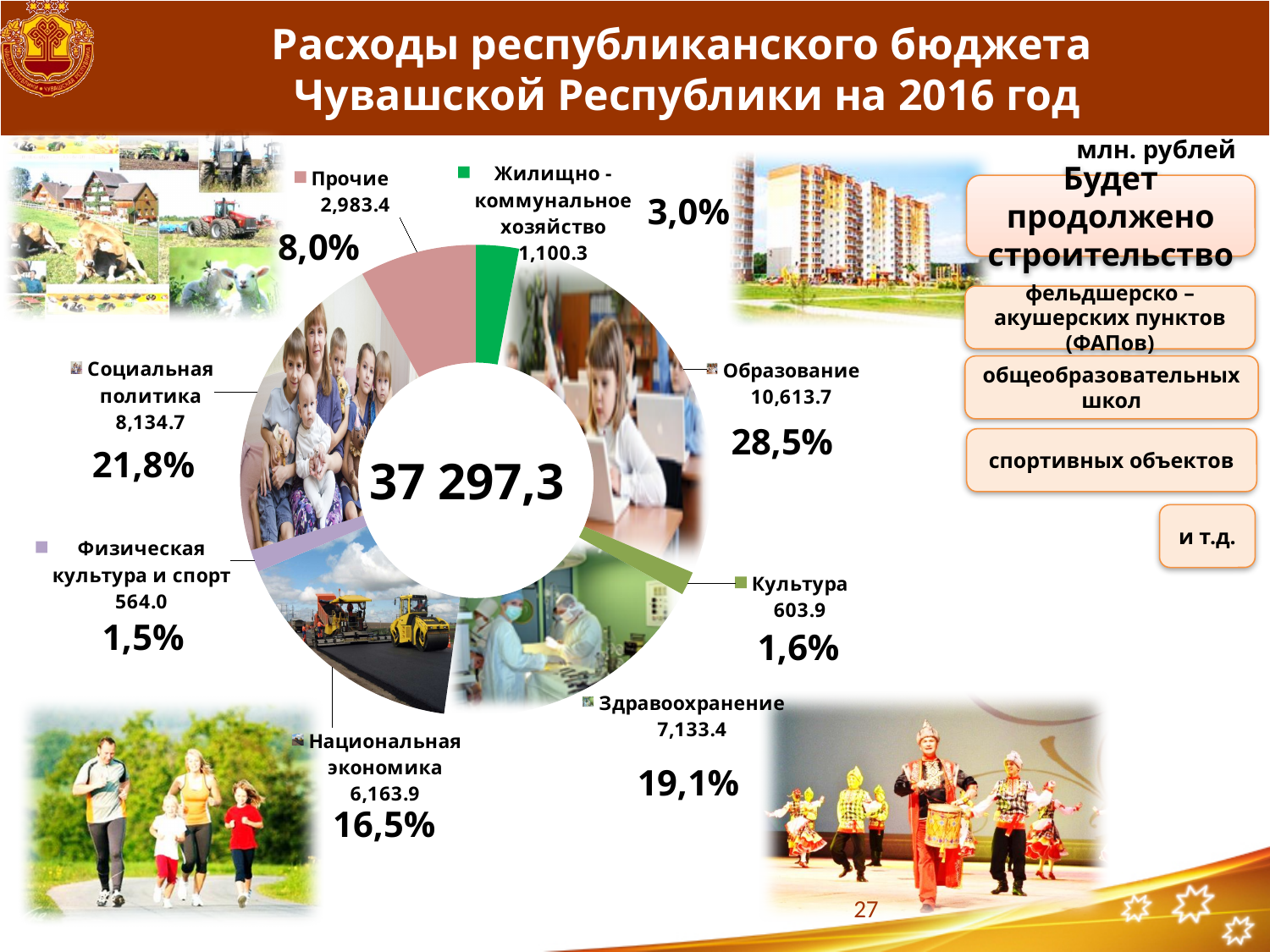
What share of the pie does Социальная политика take? 21,8% What total is printed in the centre of the chart? 37 297,3 How many categories does the chart show? 8 What share of the pie does Национальная экономика take? 16,5% What is the value for Здравоохранение? 7,133.4 Which is larger, Здравоохранение or Национальная экономика? Здравоохранение What is the value for Физическая культура и спорт? 564.0 Which category has the highest value? Образование What kind of chart is shown on the slide? pie chart (doughnut) What is the difference between the values for Образование and Социальная политика? 2,479.0 Which category has the lowest value? Физическая культура и спорт What is the value for Образование? 10,613.7